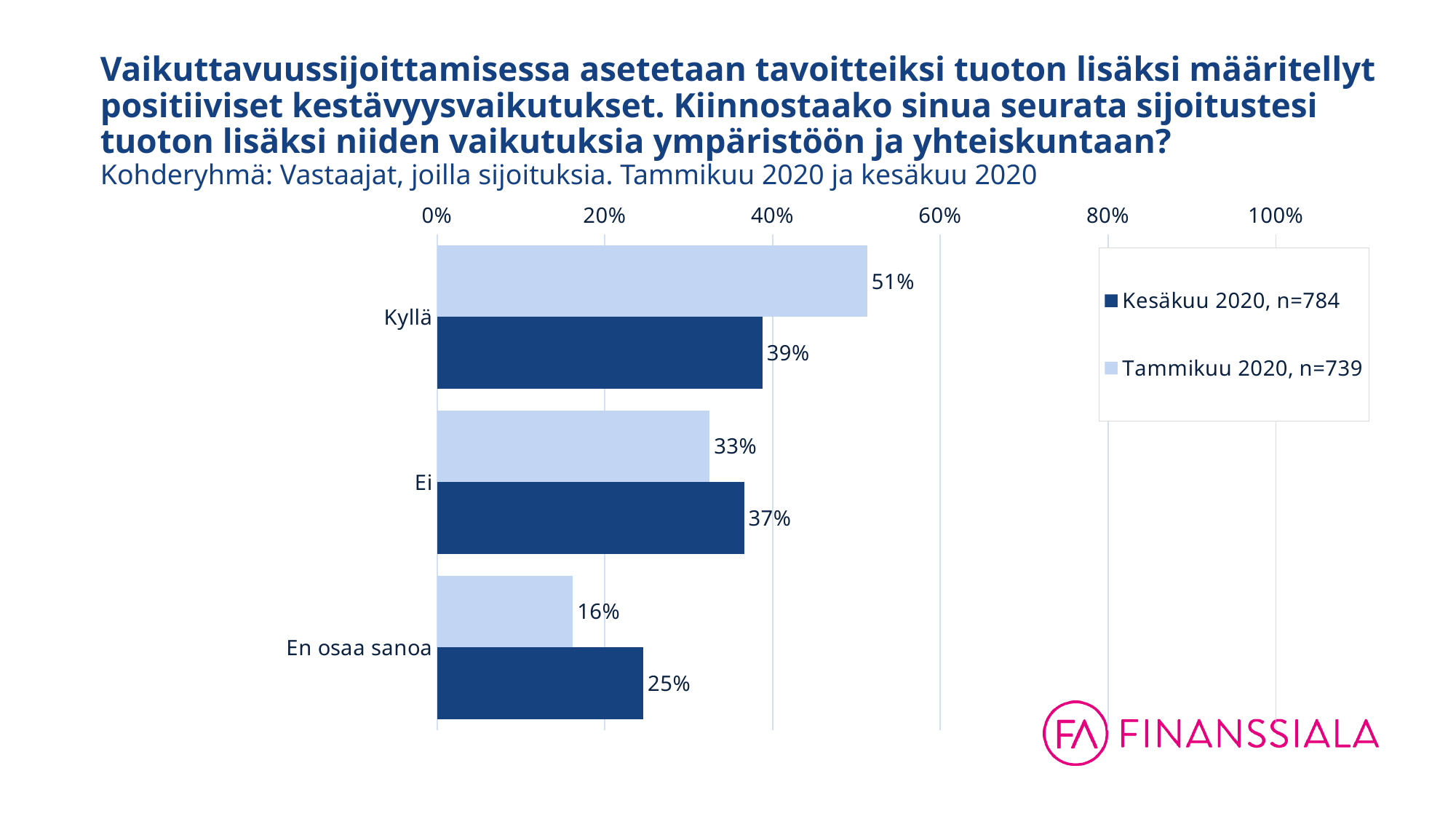
What is the value for Kyllä in the Tammikuu 2020, n=739 series? 51% Which series is shown in dark blue in the legend? Kesäkuu 2020, n=784 How many series does the legend list? 2 Which category has the highest value in the Tammikuu 2020, n=739 series? Kyllä Which category has the lowest value in the Kesäkuu 2020, n=784 series? En osaa sanoa Which is larger for Ei: the Kesäkuu 2020, n=784 value or the Tammikuu 2020, n=739 value? Kesäkuu 2020, n=784 What is the difference between the Tammikuu 2020 and Kesäkuu 2020 values for Kyllä? 12% What is the value for Kyllä in the Kesäkuu 2020, n=784 series? 39% How many categories are shown on the chart? 3 What kind of chart is shown on the slide? Bar chart What is the value for En osaa sanoa in the Kesäkuu 2020, n=784 series? 25% What is the value for Ei in the Tammikuu 2020, n=739 series? 33%